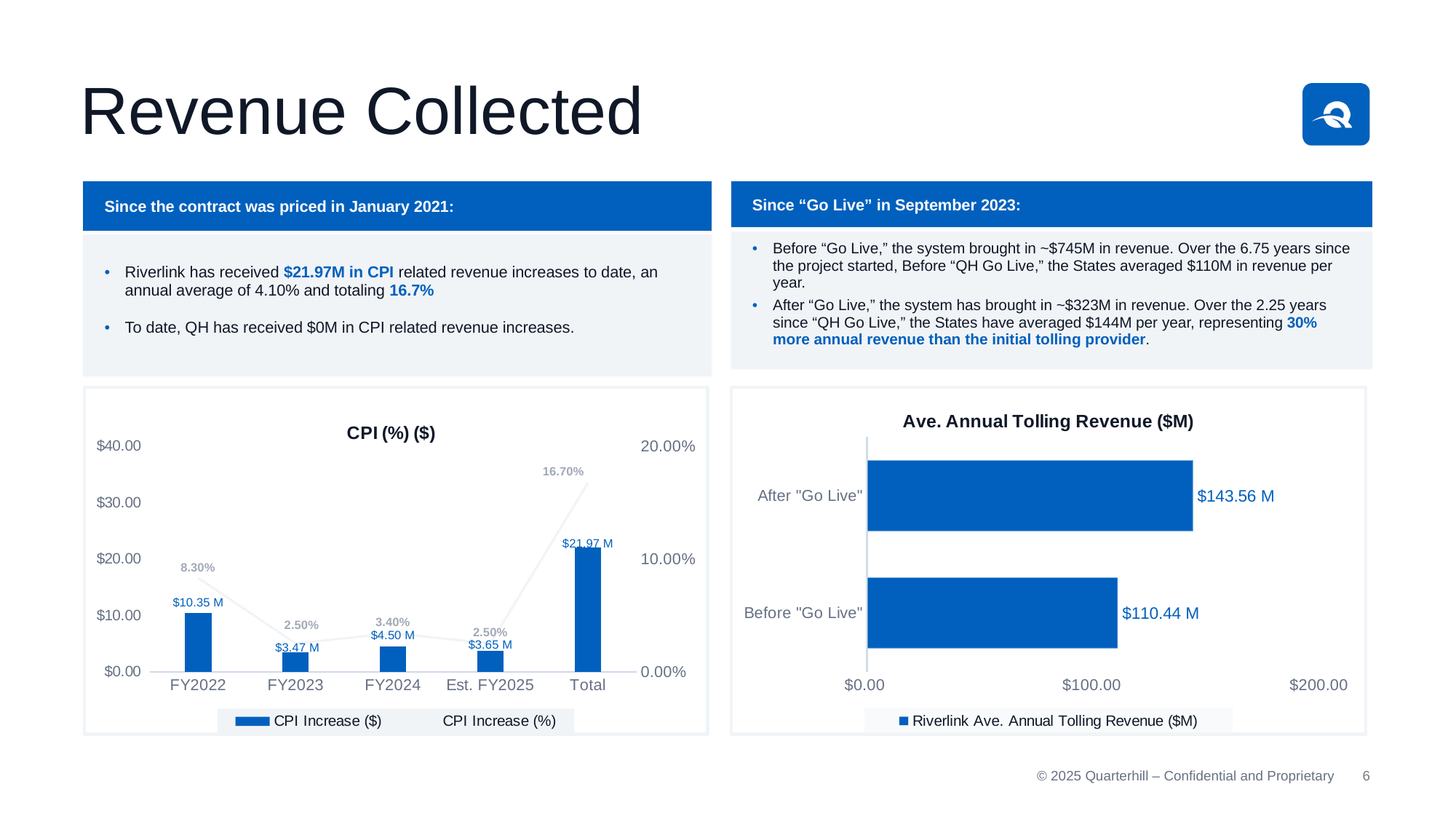
In the "CPI (%) ($)" chart, which individual fiscal year (excluding Total) has the highest CPI Increase ($)? FY2022 In the "Ave. Annual Tolling Revenue ($M)" chart, which is larger: Before "Go Live" or After "Go Live"? After "Go Live" In the "CPI (%) ($)" chart, what is the CPI Increase (%) for FY2022? 8.30% In the "CPI (%) ($)" chart, how much larger is the CPI Increase ($) for FY2022 than for FY2023? $6.88 M In the "Ave. Annual Tolling Revenue ($M)" chart, what is the value for After "Go Live"? $143.56 M In the "CPI (%) ($)" chart, what is the CPI Increase ($) for FY2024? $4.50 M How many series does the legend of the "CPI (%) ($)" chart list? 2 In the "CPI (%) ($)" chart, which category has the lowest CPI Increase ($)? FY2023 In the "CPI (%) ($)" chart, is the Total bar greater or less than $20.00 on the left axis? greater In the "Ave. Annual Tolling Revenue ($M)" chart, what is the difference between the After "Go Live" and Before "Go Live" values? $33.12 M How many categories are shown in the "Ave. Annual Tolling Revenue ($M)" chart? 2 What kind of chart is the "Ave. Annual Tolling Revenue ($M)" chart? bar chart